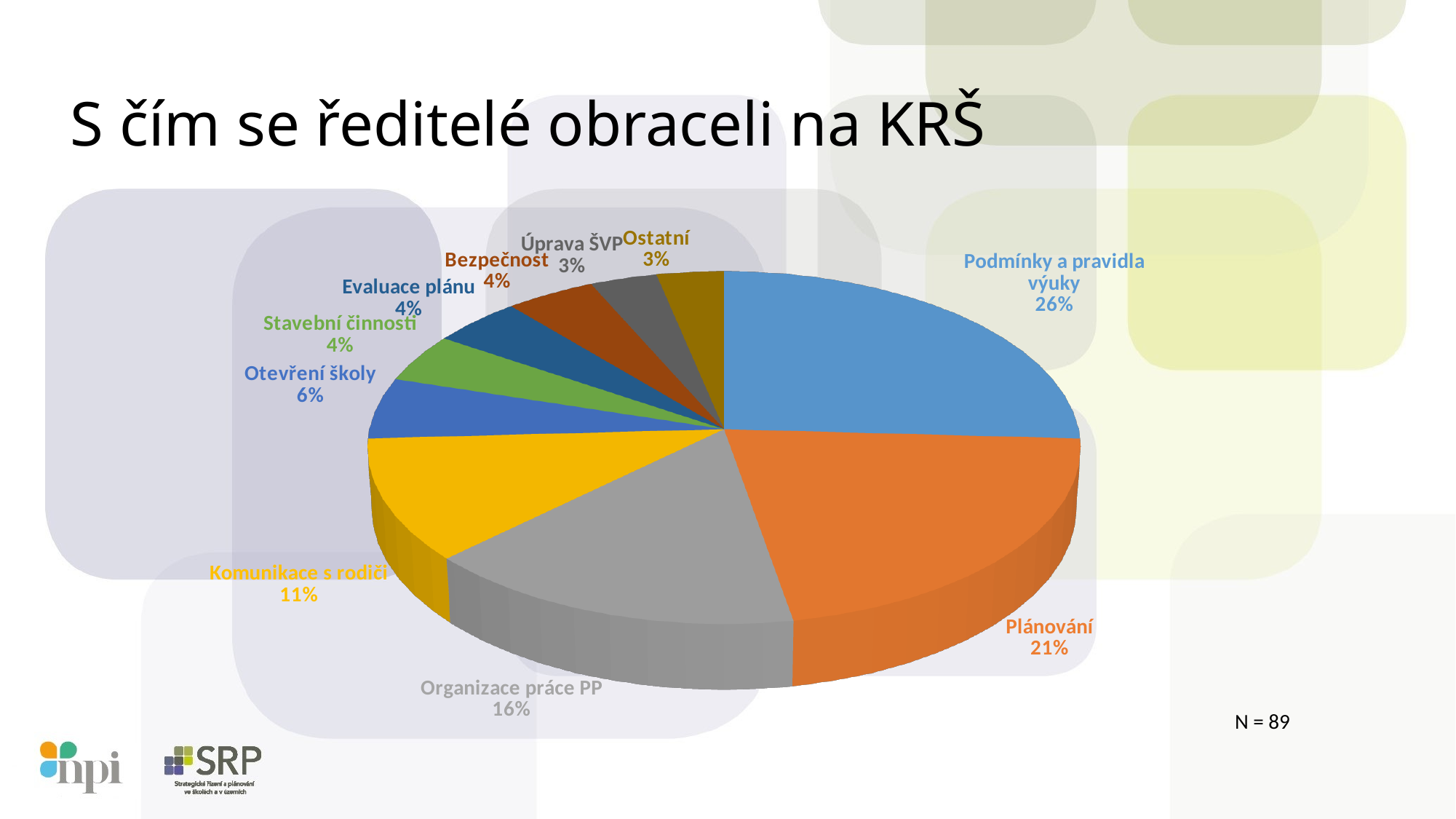
What is the value shown for "Plánování"? 21% What is the difference in percentage points between "Podmínky a pravidla výuky" and "Plánování"? 5 What kind of chart is shown on the slide? pie chart What is the title of the chart on the slide? S čím se ředitelé obraceli na KRŠ What is the value for "Komunikace s rodiči"? 11% How many categories (slices) does the pie chart have? 10 Which category has the largest share of the pie? Podmínky a pravidla výuky What share of the pie does "Podmínky a pravidla výuky" have? 26% What sample size (N) is stated on the slide? N = 89 What percentage is shown for "Otevření školy"? 6% Which is larger, "Organizace práce PP" or "Komunikace s rodiči"? Organizace práce PP What percentage is shown for "Organizace práce PP"? 16%